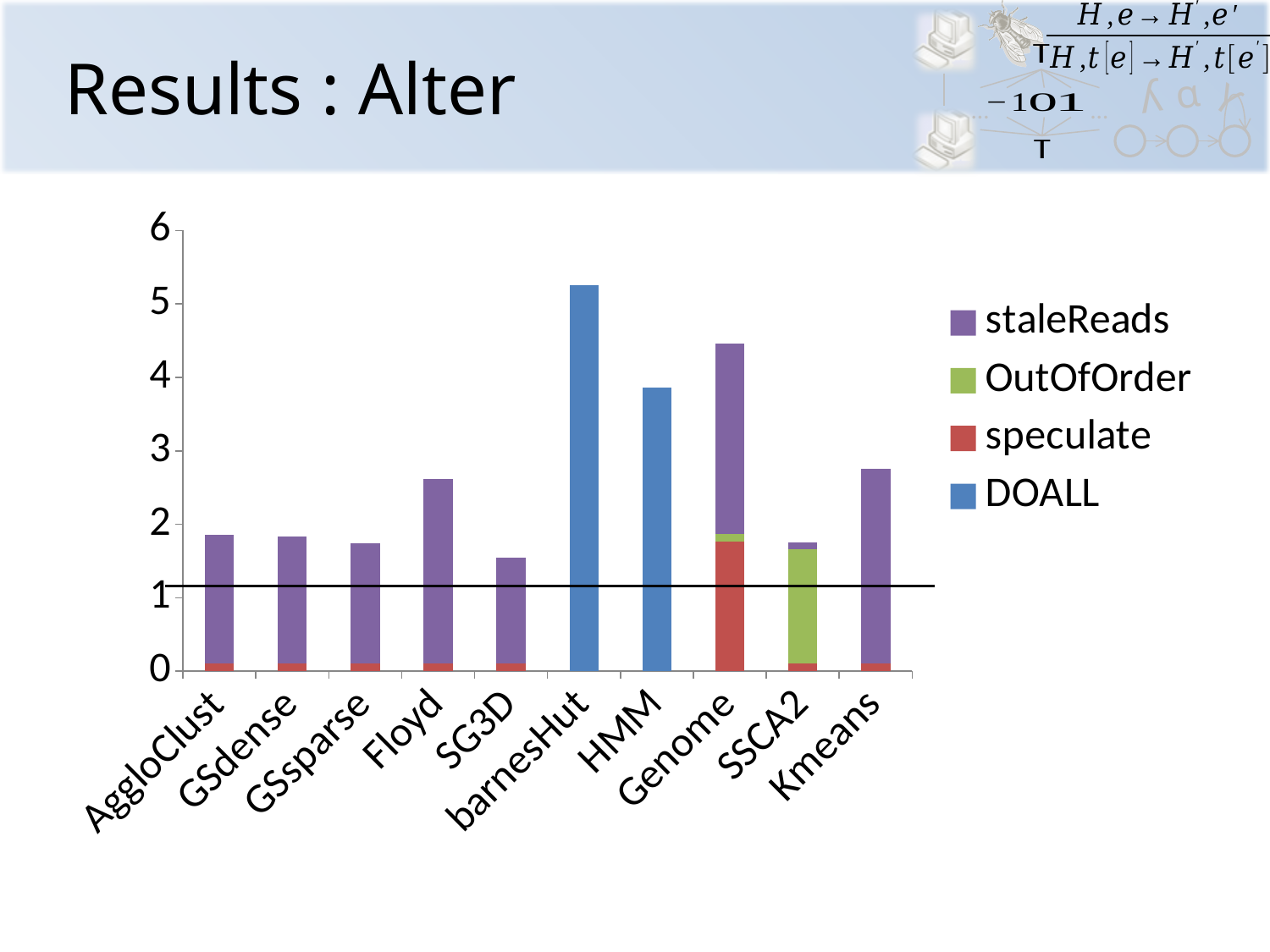
What kind of chart is shown on the slide? bar chart Is the total bar for HMM greater or less than 4? less How many series does the chart's legend list? 4 Which series is shown in blue in the chart's legend? DOALL Which category has the shortest bar in the chart? SG3D Which series is shown in green in the chart's legend? OutOfOrder Is the total bar for Genome greater or less than 4? greater Which bar is taller, Floyd or Kmeans? Kmeans Which category has the tallest bar in the chart? barnesHut Is the total bar for SG3D greater or less than 2? less How many categories are shown along the x axis of the chart? 10